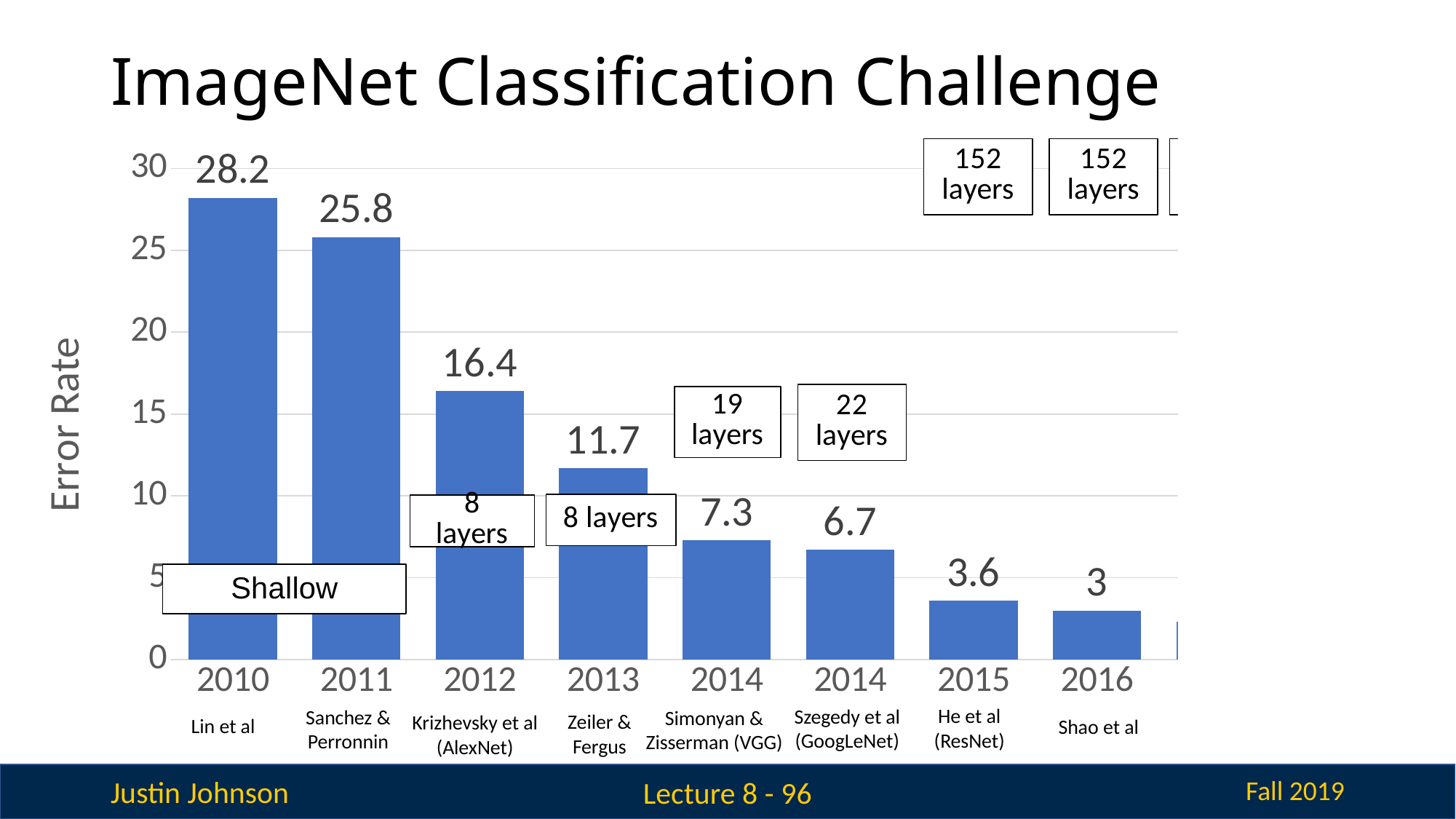
Is the error rate for Szegedy et al (GoogLeNet) greater or less than 10? less What type of chart is shown on the slide? Bar chart What is the error rate for He et al (ResNet) in 2015? 3.6 Which labeled entry has the lowest error rate? Shao et al (2016) What is the error rate for Lin et al (2010)? 28.2 Do the error rates rise or fall from 2010 to 2016? Fall What is the error rate for Simonyan & Zisserman (VGG) in 2014? 7.3 What is the error rate for Krizhevsky et al (AlexNet) in 2012? 16.4 What is the difference in error rate between Sanchez & Perronnin (2011) and Krizhevsky et al (AlexNet, 2012)? 9.4 What is the label on the y axis of the chart? Error Rate Which entry has the highest error rate? Lin et al (2010) Which has a higher error rate, Zeiler & Fergus (2013) or Szegedy et al (GoogLeNet, 2014)? Zeiler & Fergus (2013)